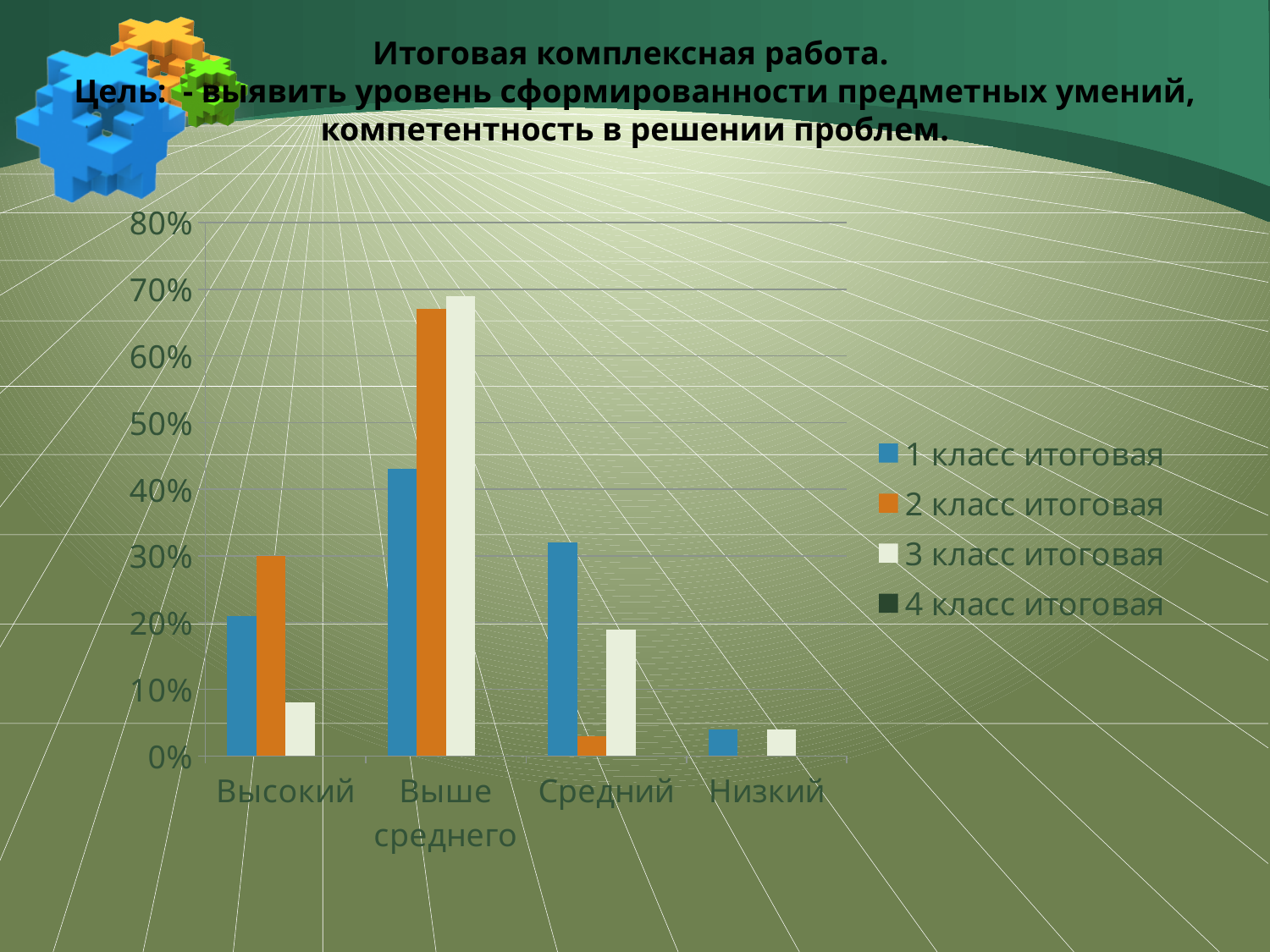
Which category has the lowest value for the series "1 класс итоговая"? Низкий Which category has the highest value for the series "1 класс итоговая"? Выше среднего In the category "Высокий", which series has the larger value: "1 класс итоговая" or "2 класс итоговая"? 2 класс итоговая What colour are the bars for the series "2 класс итоговая"? orange How many categories are shown on the x axis of the chart? 4 Which category has the highest value for the series "2 класс итоговая"? Выше среднего Is the value for "3 класс итоговая" in the category "Высокий" greater or less than 10%? less What kind of chart is shown on the slide? bar chart Is the value for "2 класс итоговая" in the category "Выше среднего" greater or less than 60%? greater In the category "Средний", which series has the larger value: "2 класс итоговая" or "3 класс итоговая"? 3 класс итоговая Is the value for "1 класс итоговая" in the category "Средний" greater or less than 30%? greater How many series does the chart's legend list? 4